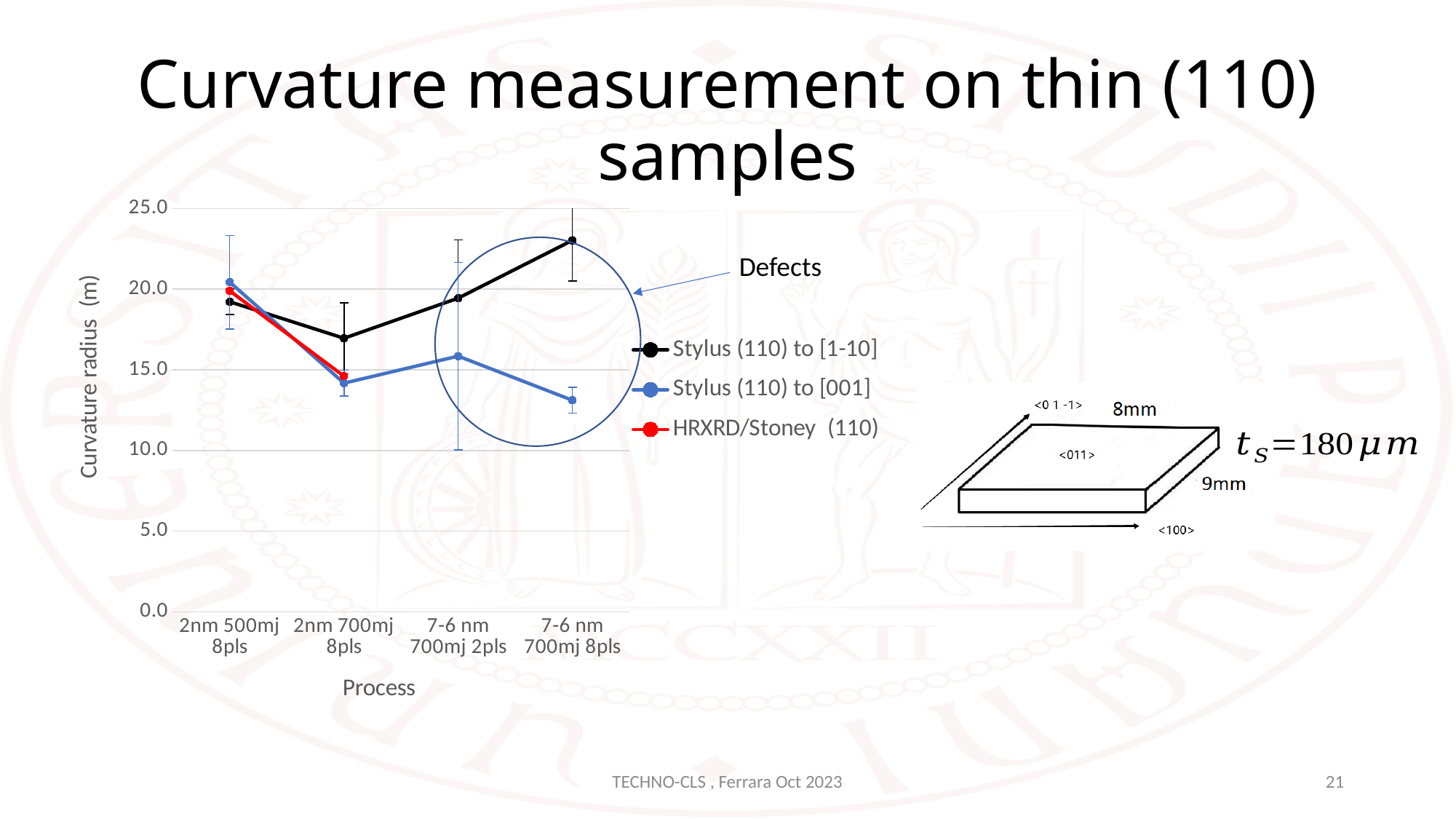
Is the value of Stylus (110) to [001] for 2nm 500mj 8pls greater or less than 20.0? greater For which process is the Stylus (110) to [001] series lowest? 7-6 nm 700mj 8pls Is the value of Stylus (110) to [001] for 7-6 nm 700mj 8pls greater or less than 15.0? less Does the HRXRD/Stoney (110) series rise or fall from 2nm 500mj 8pls to 2nm 700mj 8pls? fall How many series does the chart legend list? 3 Which colour is used for the HRXRD/Stoney (110) series in the chart? red What kind of chart is shown on the slide? line chart What is the label of the y axis of the chart? Curvature radius (m) For which process is the Stylus (110) to [1-10] series highest? 7-6 nm 700mj 8pls How many process categories are shown on the x axis of the chart? 4 At 7-6 nm 700mj 8pls, which series has the larger curvature radius: Stylus (110) to [1-10] or Stylus (110) to [001]? Stylus (110) to [1-10] Is the value of Stylus (110) to [1-10] for 7-6 nm 700mj 8pls greater or less than 20.0? greater